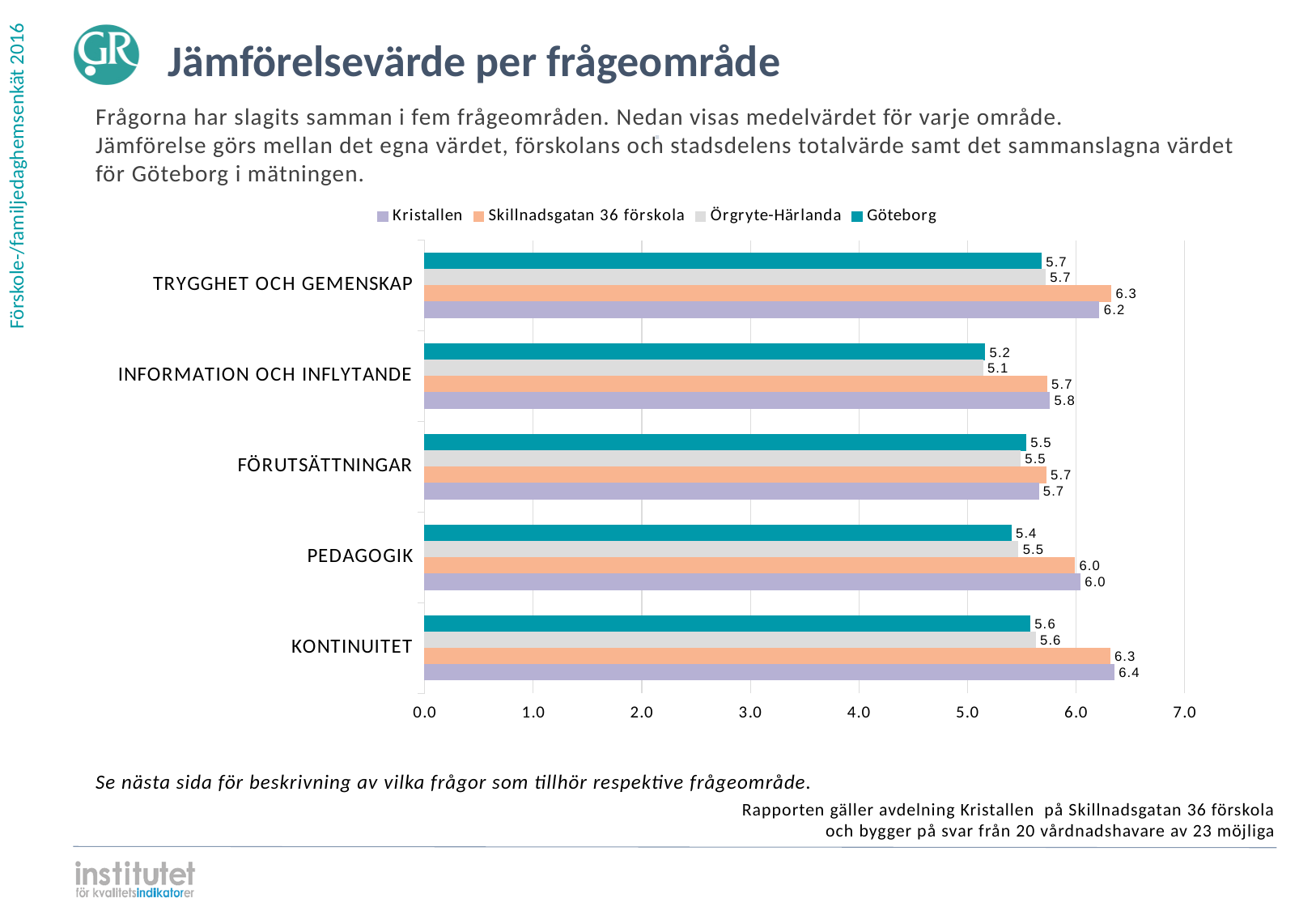
In which category does Göteborg have its lowest value? INFORMATION OCH INFLYTANDE How many series does the legend list? 4 Which series is shown in teal (dark green) on the chart? Göteborg What kind of chart is shown on the slide? Bar chart What is the value for Skillnadsgatan 36 förskola in the PEDAGOGIK category? 6.0 In which category does Kristallen have its highest value? KONTINUITET In the PEDAGOGIK category, which is larger: the value for Skillnadsgatan 36 förskola or the value for Göteborg? Skillnadsgatan 36 förskola What is the value for Örgryte-Härlanda in the TRYGGHET OCH GEMENSKAP category? 5.7 How many categories (frågeområden) are shown on the chart? 5 What is the difference between the Kristallen value and the Göteborg value in the INFORMATION OCH INFLYTANDE category? 0.6 What is the value for Göteborg in the INFORMATION OCH INFLYTANDE category? 5.2 What is the value for Kristallen in the KONTINUITET category? 6.4